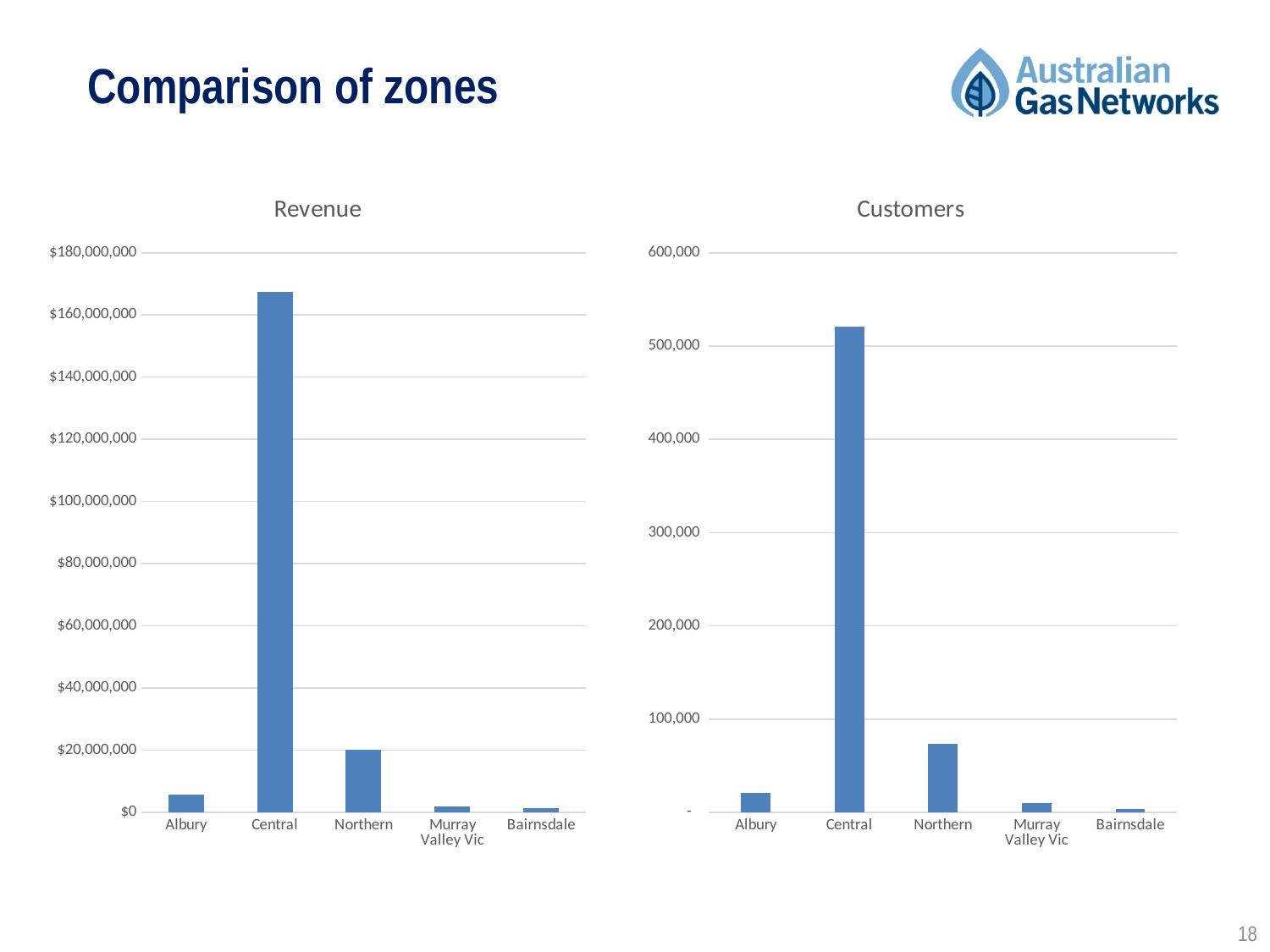
What is the title of the chart on the right side of the slide? Customers On the Customers chart, which zone has the fewest customers? Bairnsdale On the Customers chart, is the value for Central greater or less than 500,000? greater On the Customers chart, is the value for Northern greater or less than 100,000? less On the Customers chart, which zone has the most customers? Central On the Revenue chart, is the value for Albury greater or less than $20,000,000? less On the Revenue chart, which zone has the highest revenue? Central On the Revenue chart, which has higher revenue, Albury or Northern? Northern On the Customers chart, which has more customers, Albury or Murray Valley Vic? Albury How many zones are shown on the Customers chart? 5 What kind of chart is the Revenue chart? bar chart